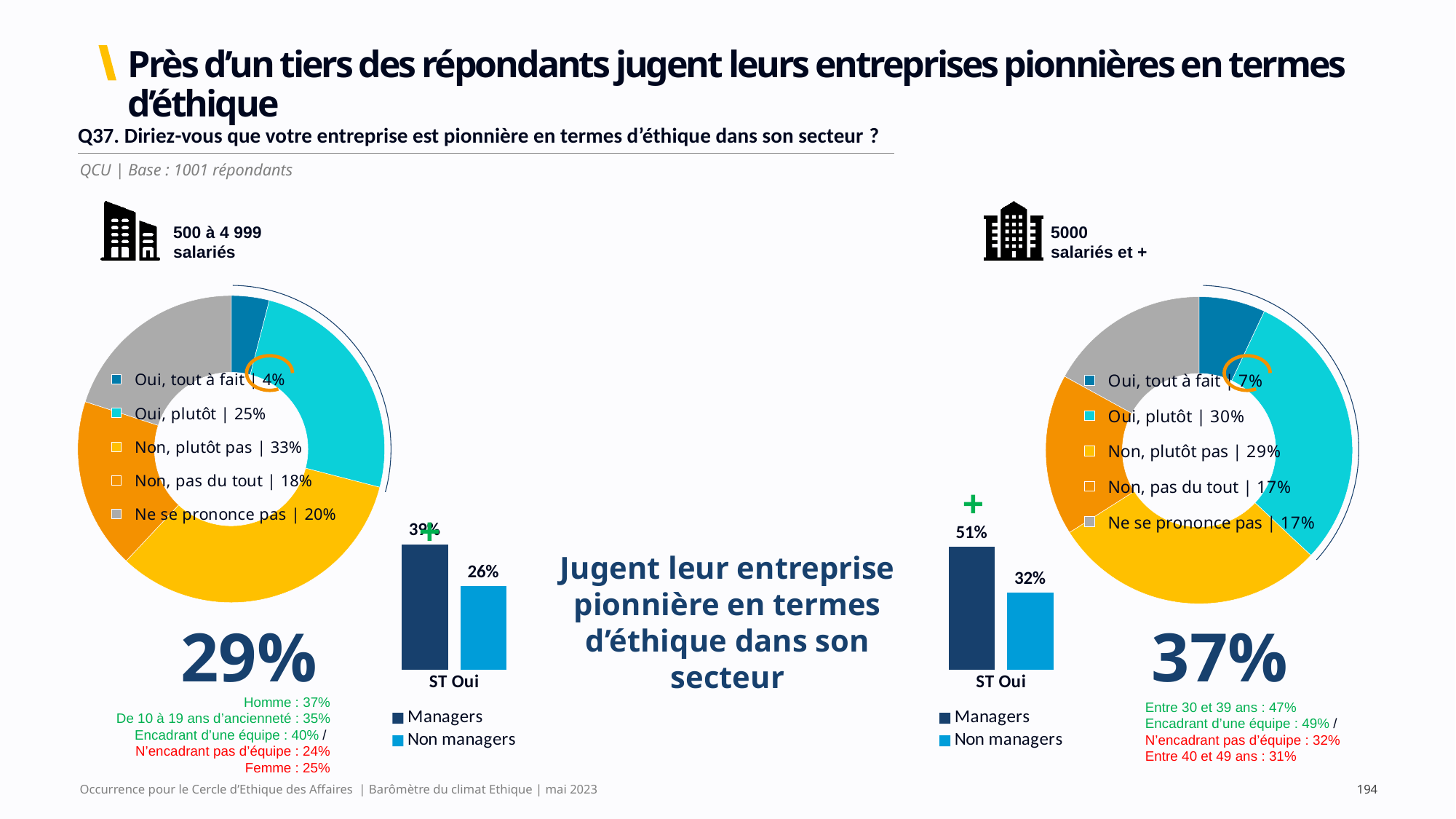
How many categories does the donut chart for '500 à 4 999 salariés' show? 5 In the 'ST Oui' bar chart for '5000 salariés et +', what is the value for Managers? 51% In the 'ST Oui' bar chart for '5000 salariés et +', what is the difference between Managers and Non managers? 19% In the donut chart for '500 à 4 999 salariés', which category has the smallest share? Oui, tout à fait What kind of chart is the 'ST Oui' chart for '500 à 4 999 salariés'? Bar chart How many series does the legend of the 'ST Oui' bar chart for '5000 salariés et +' list? 2 In the 'ST Oui' bar chart for '500 à 4 999 salariés', which is larger, Managers or Non managers? Managers In the donut chart for '5000 salariés et +', what is the value for 'Oui, tout à fait'? 7% In the donut chart for '5000 salariés et +', what is the difference between 'Oui, plutôt' and 'Non, pas du tout'? 13% In the donut chart for '500 à 4 999 salariés', which category has the largest share? Non, plutôt pas In the donut chart for '500 à 4 999 salariés', what is the value for 'Non, plutôt pas'? 33% In the donut chart for '5000 salariés et +', what is the value for 'Oui, plutôt'? 30%